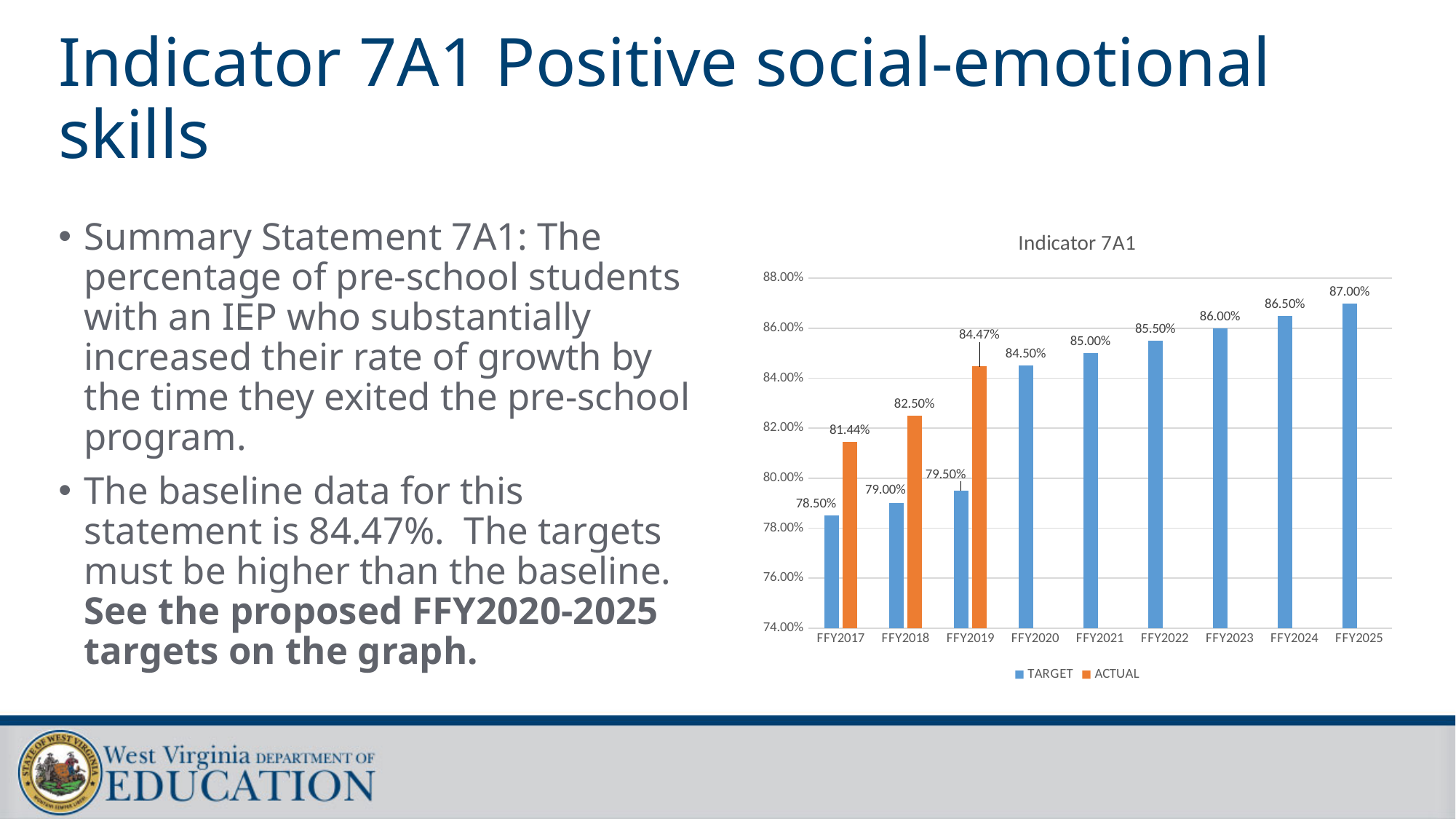
What kind of chart is shown? Bar chart How many series does the legend list? 2 What is the TARGET value for FFY2025? 87.00% Which is larger for FFY2019, the TARGET or the ACTUAL value? ACTUAL What colour are the ACTUAL bars? Orange Do the TARGET values rise or fall from FFY2017 to FFY2025? Rise What is the difference between the ACTUAL and TARGET values for FFY2018? 3.50% How many years are shown on the x axis? 9 What is the ACTUAL value for FFY2019? 84.47% Which year has the lowest ACTUAL value? FFY2017 Which year has the highest TARGET value? FFY2025 What is the TARGET value for FFY2017? 78.50%